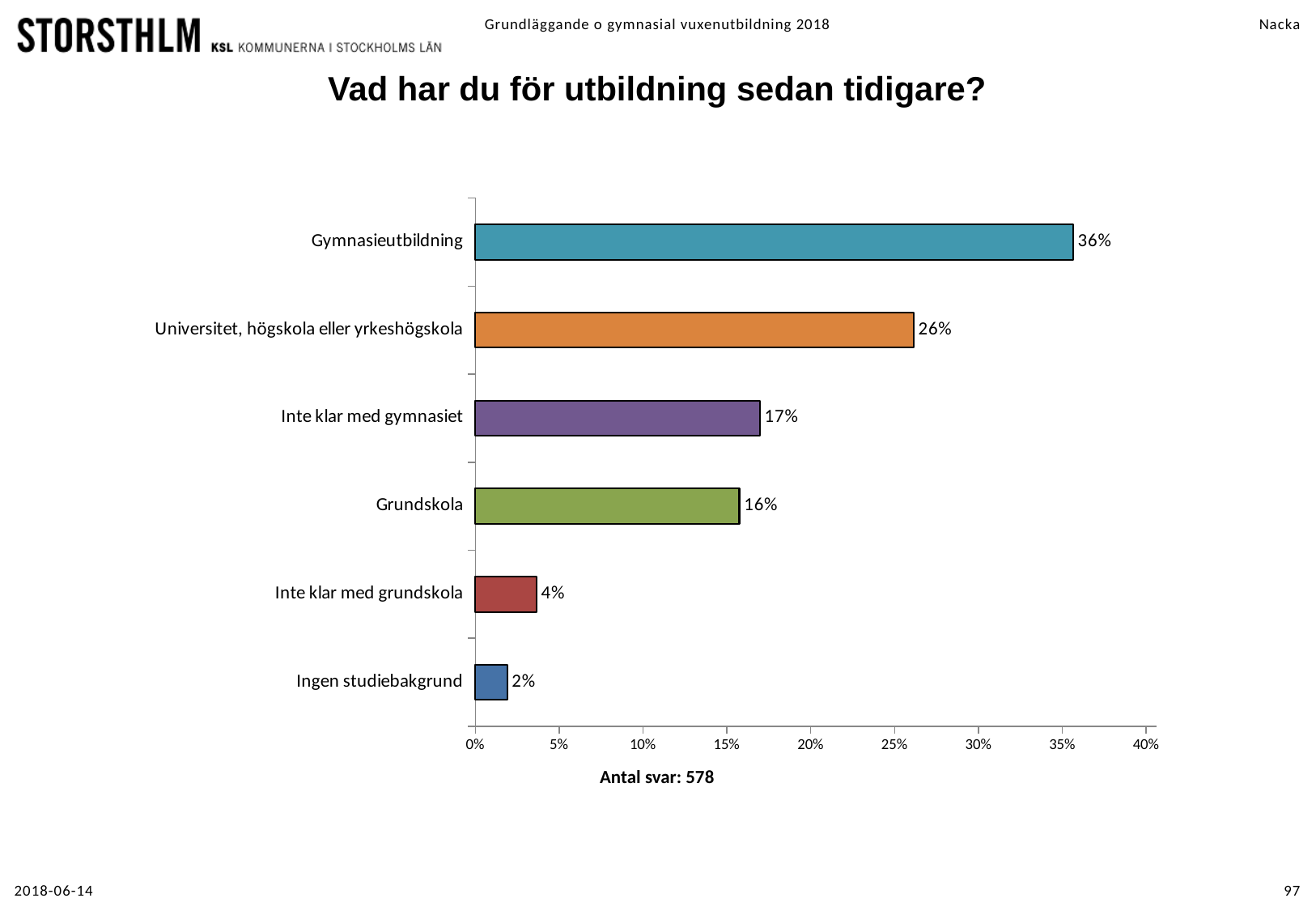
What is the title of the chart? Vad har du för utbildning sedan tidigare? What is the value for Gymnasieutbildning? 36% What is the difference between the values for Gymnasieutbildning and Universitet, högskola eller yrkeshögskola? 10% What is the value for Inte klar med grundskola? 4% Is the value for Universitet, högskola eller yrkeshögskola greater or less than 25%? greater Which is larger, the value for Inte klar med gymnasiet or the value for Inte klar med grundskola? Inte klar med gymnasiet What kind of chart is shown on the slide? bar chart What is the value for Universitet, högskola eller yrkeshögskola? 26% What is the difference between the values for Grundskola and Ingen studiebakgrund? 14% Which category has the highest value? Gymnasieutbildning How many categories are shown in the chart? 6 Which category has the lowest value? Ingen studiebakgrund